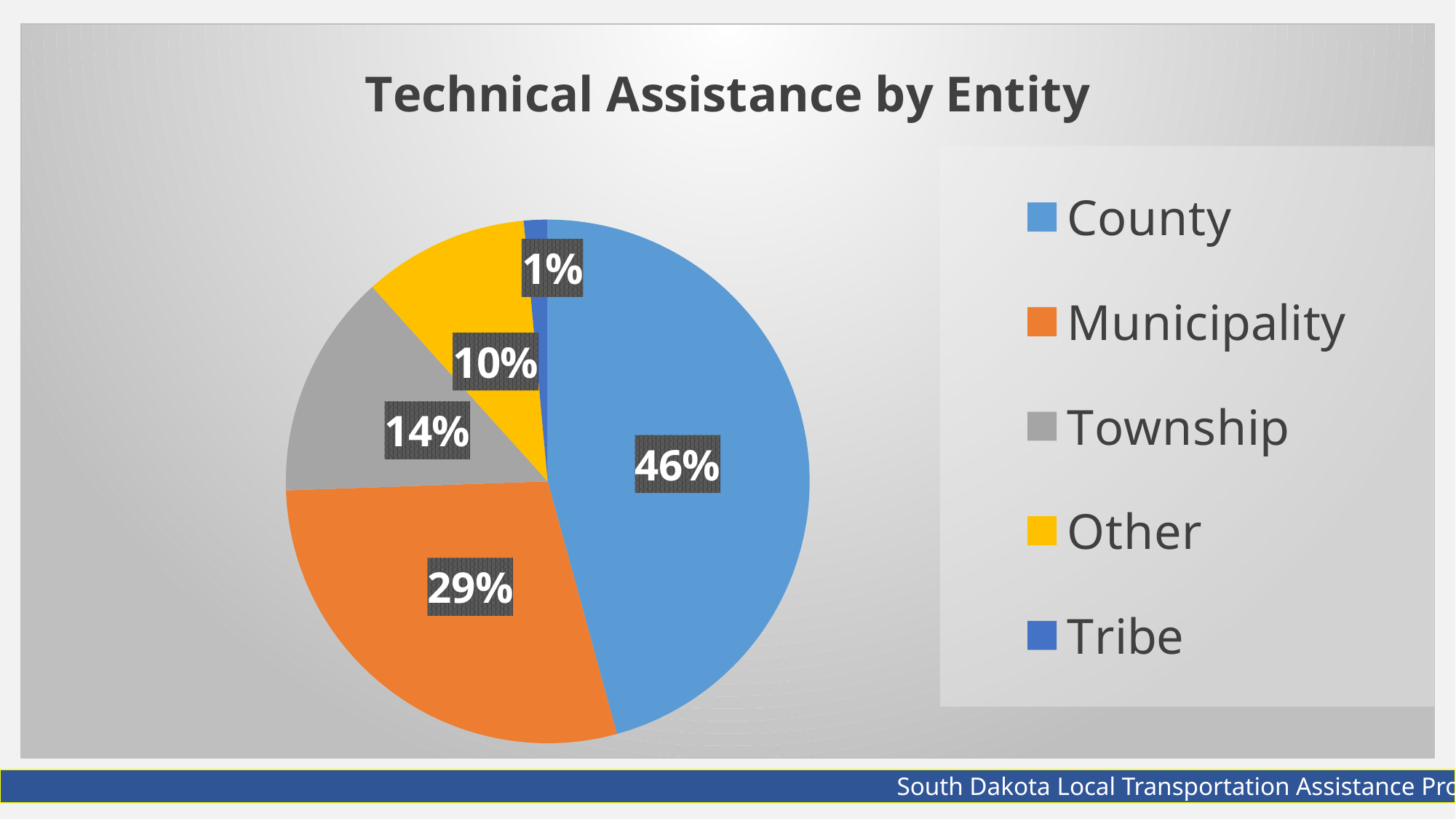
What share of technical assistance goes to Other? 10% Which entity has the largest share of technical assistance? County Which has a larger share, Township or Other? Township How many entities are listed in the legend? 5 Which entity has the smallest share of technical assistance? Tribe What type of chart is shown on the slide? pie chart What share of technical assistance goes to Township? 14% What share of technical assistance goes to Municipality? 29% What share of technical assistance goes to County? 46% What is the title of the chart? Technical Assistance by Entity What share of technical assistance goes to Tribe? 1% What is the difference in percentage points between the County and Municipality shares? 17